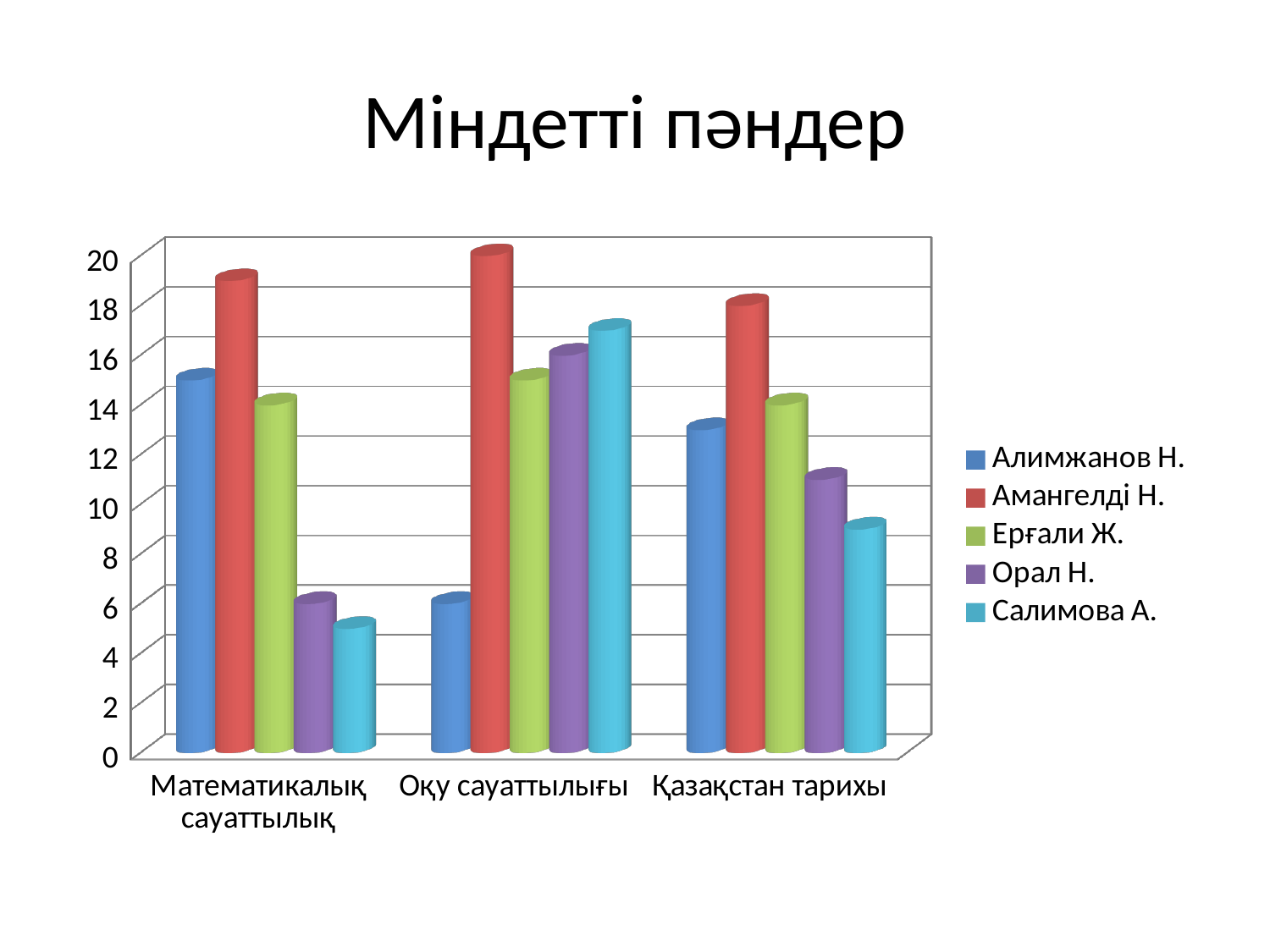
Which student has the highest value for Оқу сауаттылығы? Амангелді Н. What kind of chart is shown on the slide? bar chart How many subject categories are shown on the x axis? 3 How many series does the legend list? 5 Which student has the highest value for Қазақстан тарихы? Амангелді Н. Is the value for Орал Н. in Математикалық сауаттылық greater or less than 10? less Which series is shown in red in the legend? Амангелді Н. Which student has the lowest value for Математикалық сауаттылық? Салимова А. Is the value for Амангелді Н. in Математикалық сауаттылық greater or less than 16? greater For Қазақстан тарихы, which is larger: the value for Алимжанов Н. or the value for Салимова А.? Алимжанов Н. What is the title of the chart? Міндетті пәндер Which student has the lowest value for Оқу сауаттылығы? Алимжанов Н.